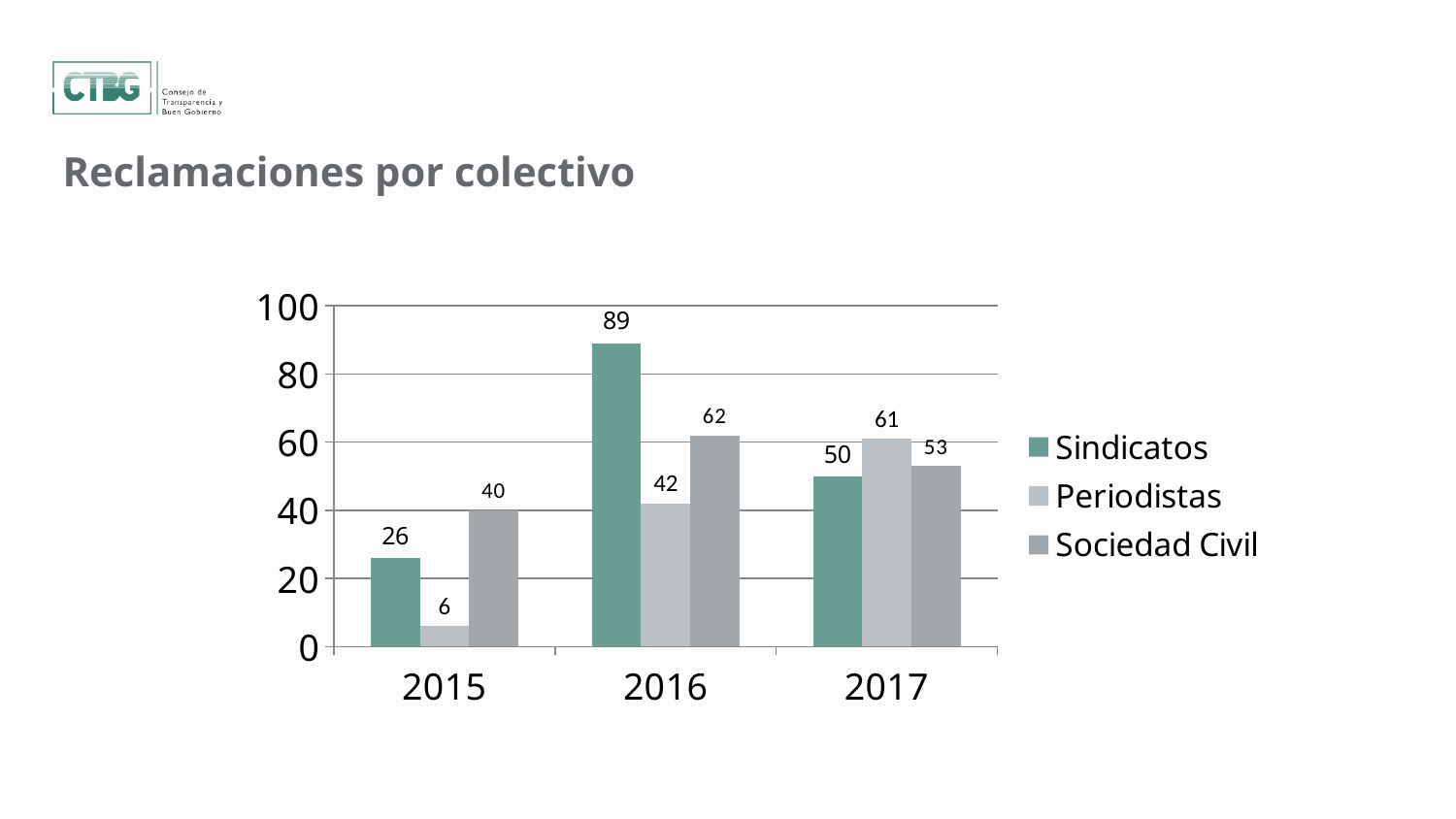
What is the difference between the Sindicatos and Periodistas values in 2016? 47 How many series does the legend list? 3 What is the value for Sociedad Civil in 2017? 53 In which year is the value for Periodistas lowest? 2015 Do the values for Periodistas rise or fall from 2015 to 2017? Rise What is the value for Periodistas in 2015? 6 What kind of chart is shown on the slide? Bar chart Which is larger in 2017, Periodistas or Sociedad Civil? Periodistas What is the value for Sindicatos in 2016? 89 In which year is the value for Sindicatos highest? 2016 How many years are shown on the x axis? 3 What is the title of the slide? Reclamaciones por colectivo